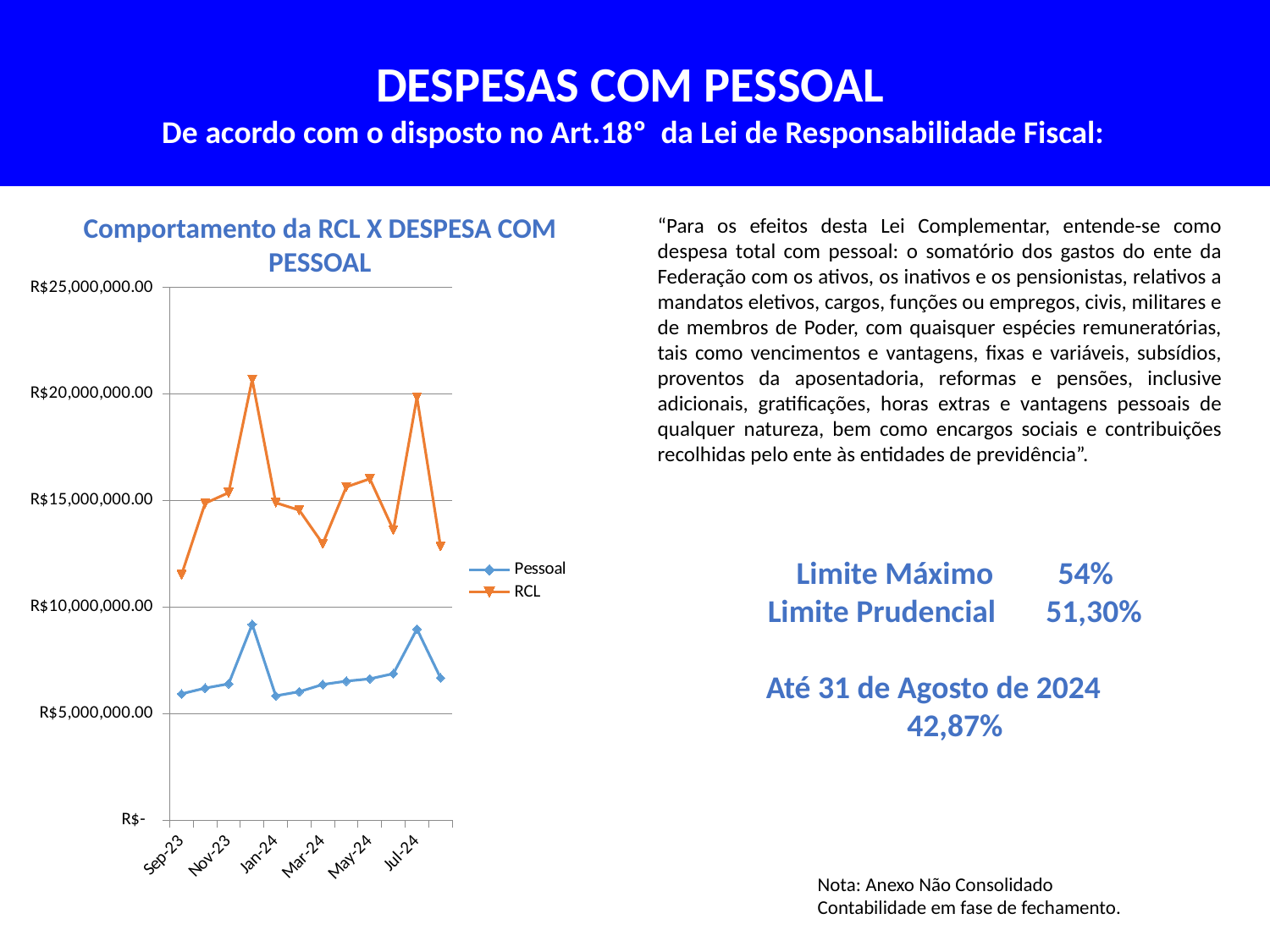
Is the RCL value for Jul-24 greater or less than R$15,000,000.00? greater At Sep-23, which series has the larger value, Pessoal or RCL? RCL Is the RCL value for Mar-24 greater or less than R$15,000,000.00? less How many series does the chart's legend list? 2 At which month is the RCL series at its lowest? Sep-23 Is the Pessoal value for Sep-23 greater or less than R$5,000,000.00? greater What is the title of the chart? Comportamento da RCL X DESPESA COM PESSOAL What kind of chart is shown on the slide? Line chart How many monthly data points does each series have? 12 Which series is drawn in orange in the chart? RCL